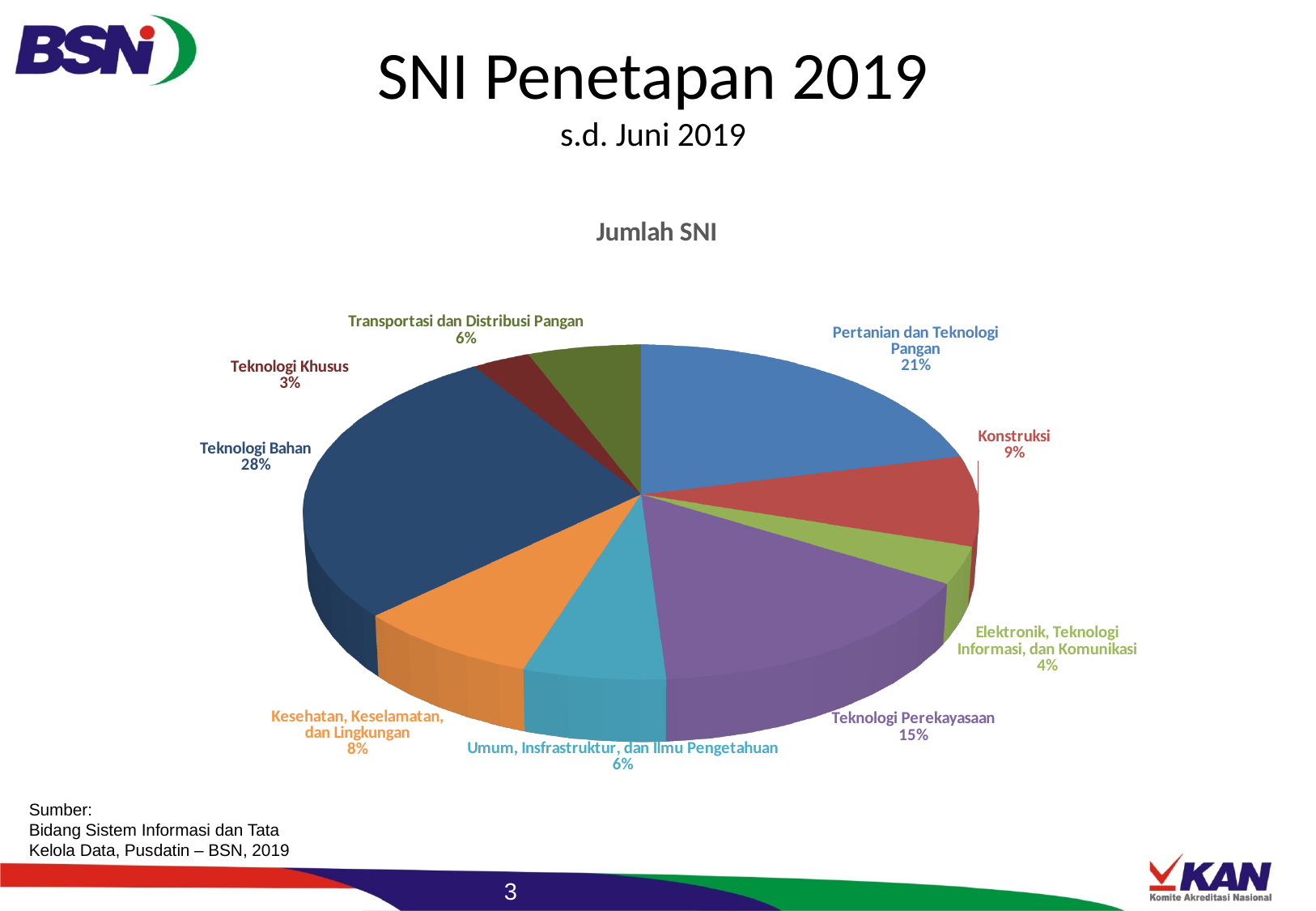
What percentage is shown for Transportasi dan Distribusi Pangan? 6% Which category has the smallest share of the pie? Teknologi Khusus Which category has the largest share of the pie? Teknologi Bahan What share of the pie does Teknologi Bahan represent? 28% How many categories (slices) does the pie chart have? 9 What percentage is shown for Konstruksi? 9% What percentage is shown for Teknologi Perekayasaan? 15% What kind of chart is shown on the slide? Pie chart What is the title of the chart? Jumlah SNI What share of the pie does Pertanian dan Teknologi Pangan represent? 21% Which is larger: Kesehatan, Keselamatan, dan Lingkungan or Elektronik, Teknologi Informasi, dan Komunikasi? Kesehatan, Keselamatan, dan Lingkungan What is the difference in percentage points between Teknologi Bahan and Pertanian dan Teknologi Pangan? 7 percentage points